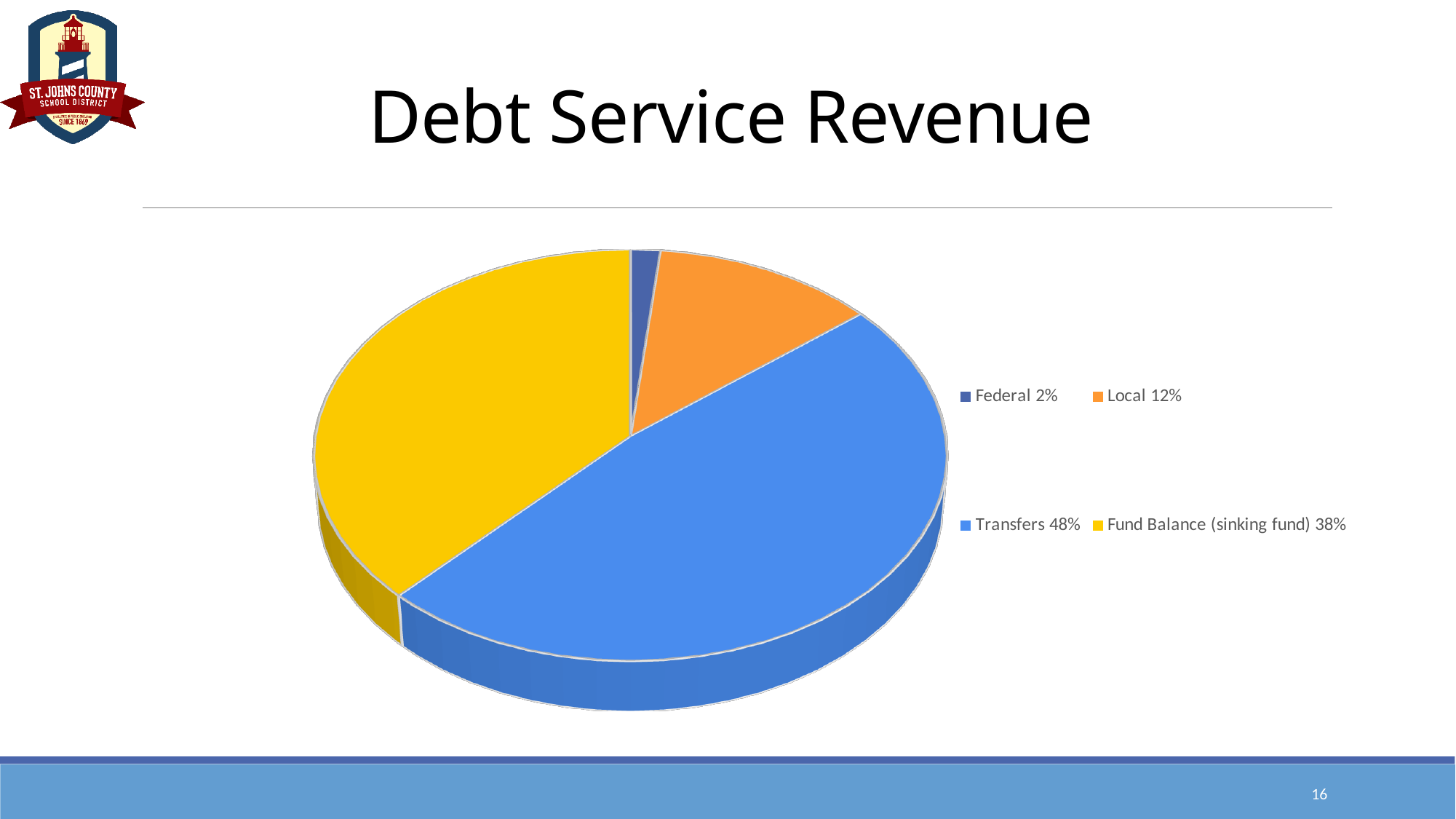
What kind of chart is shown on the slide? pie chart Which is larger, the Local share or the Federal share? Local What share of Debt Service Revenue comes from Federal? 2% What is the title of the chart? Debt Service Revenue What share of Debt Service Revenue comes from Transfers? 48% What is the difference in percentage points between Transfers and Fund Balance (sinking fund)? 10 Which category has the smallest share of Debt Service Revenue? Federal How many categories does the pie chart show? 4 What share of Debt Service Revenue comes from Local? 12% Which category has the largest share of Debt Service Revenue? Transfers What is the difference in percentage points between Local and Federal? 10